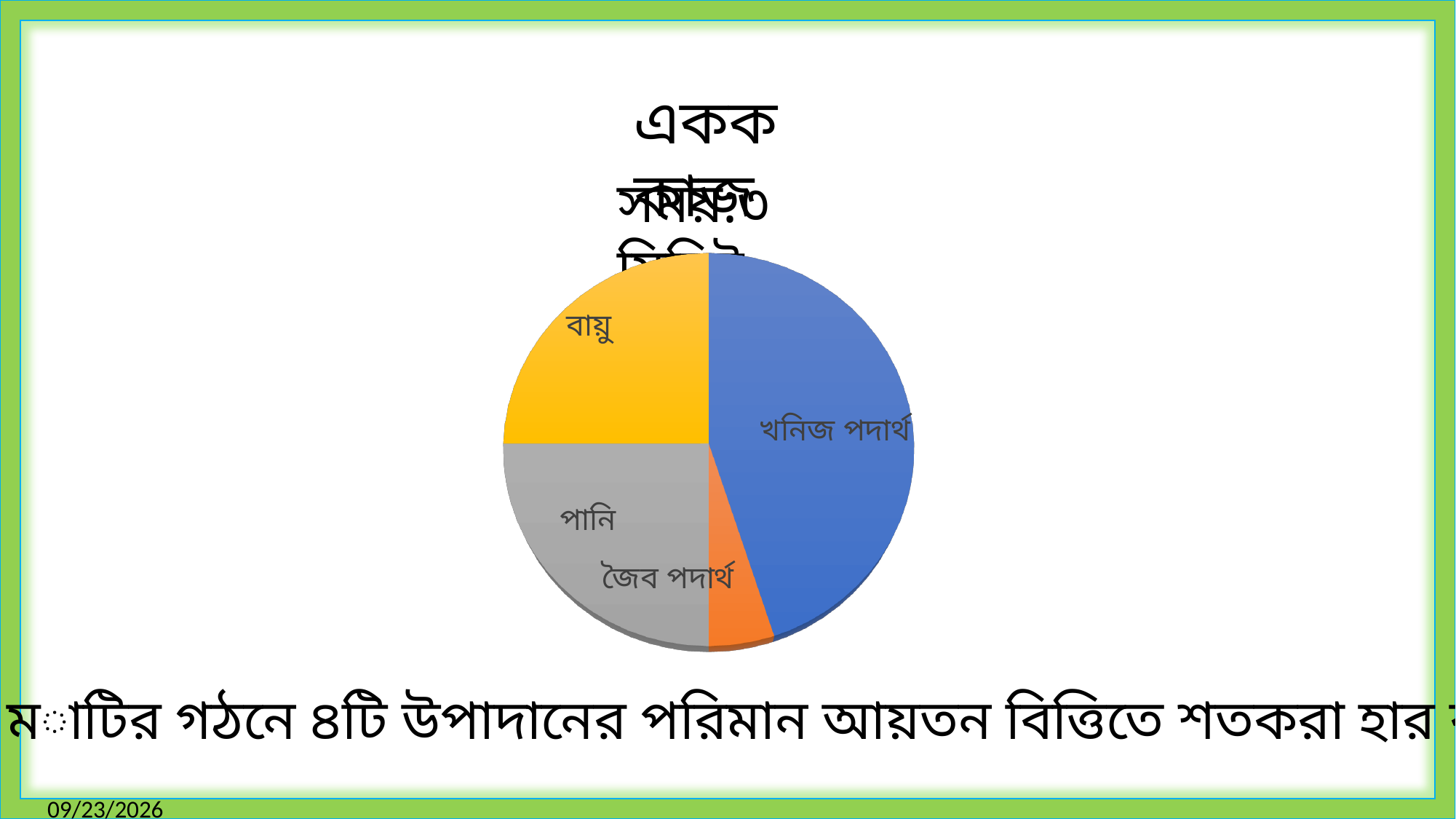
How many slices does the pie chart have? 4 Which slice of the pie chart is the smallest? জৈব পদার্থ What kind of chart is shown on the slide? pie chart What colour is the খনিজ পদার্থ slice in the pie chart? blue Which is larger in the pie chart, বায়ু or জৈব পদার্থ? বায়ু Which is larger in the pie chart, খনিজ পদার্থ or পানি? খনিজ পদার্থ Which slice of the pie chart is the largest? খনিজ পদার্থ Which is larger in the pie chart, খনিজ পদার্থ or জৈব পদার্থ? খনিজ পদার্থ Which slice of the pie chart is coloured orange? জৈব পদার্থ